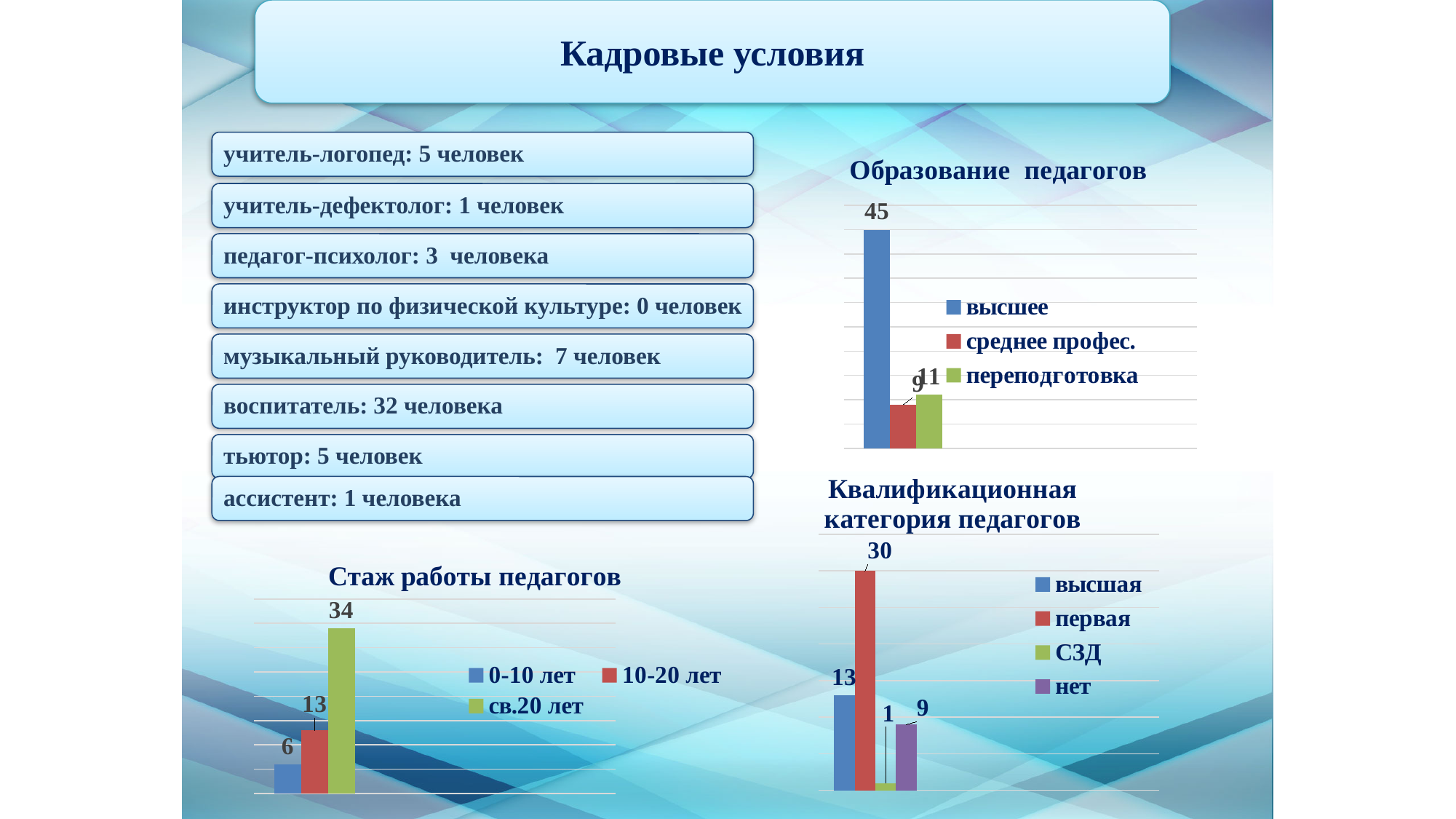
In the chart 'Образование педагогов', which category has the highest value? высшее In the chart 'Квалификационная категория педагогов', which is larger, 'высшая' or 'нет'? высшая What kind of chart is 'Стаж работы педагогов'? bar chart In the chart 'Стаж работы педагогов', what is the difference between the values for 'св.20 лет' and '10-20 лет'? 21 In the chart 'Квалификационная категория педагогов', what is the value for 'первая'? 30 In the chart 'Образование педагогов', what is the value for 'высшее'? 45 In the chart 'Образование педагогов', how many series does the legend list? 3 In the chart 'Стаж работы педагогов', which category has the lowest value? 0-10 лет In the chart 'Стаж работы педагогов', what is the value for 'св.20 лет'? 34 In the chart 'Квалификационная категория педагогов', which category has the lowest value? СЗД In the chart 'Квалификационная категория педагогов', how many series does the legend list? 4 In the chart 'Образование педагогов', what is the value for 'переподготовка'? 11